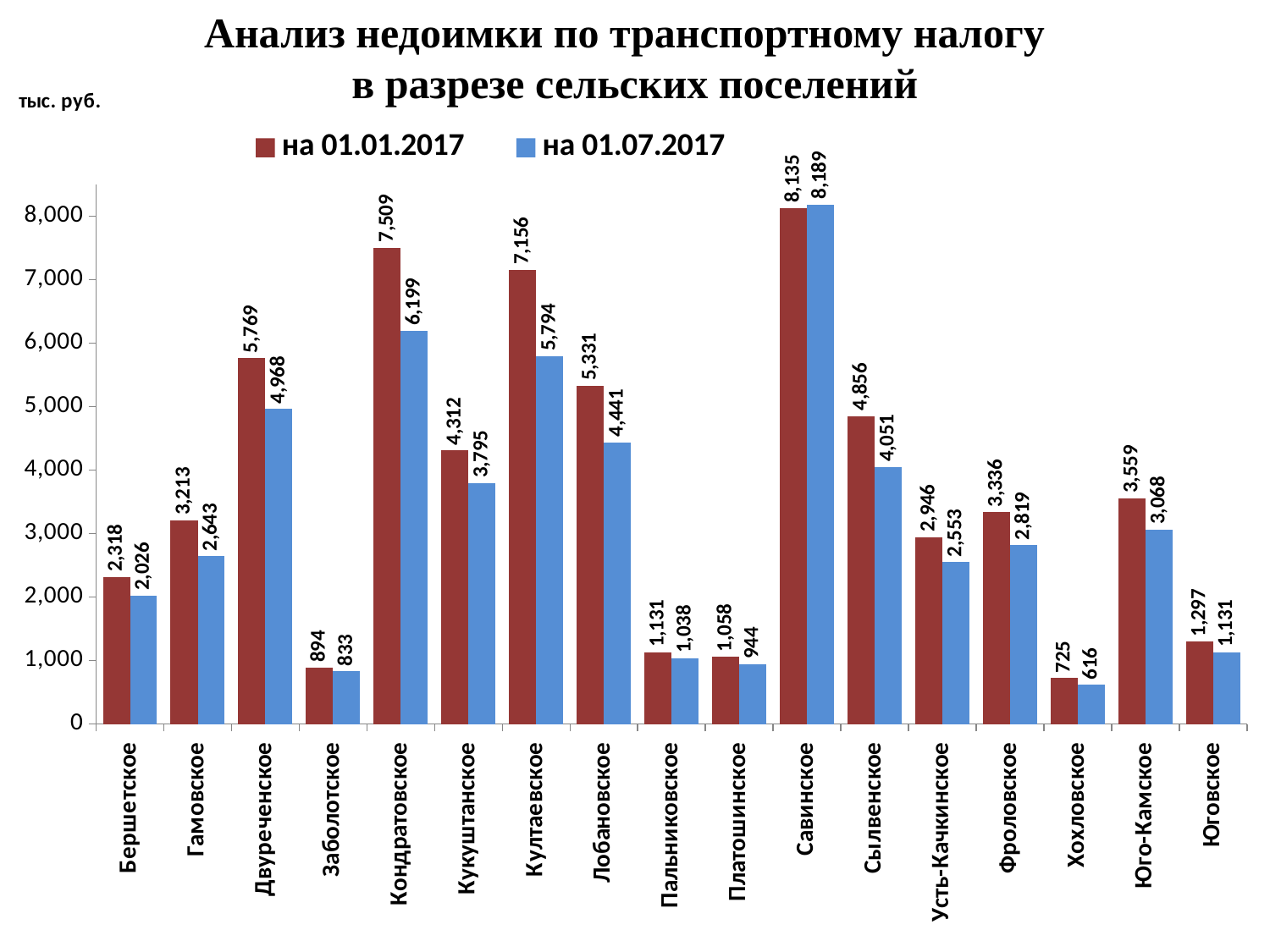
What is the value for Савинское in the series на 01.07.2017? 8,189 What is the difference between the на 01.01.2017 and на 01.07.2017 values for Кондратовское? 1,310 What kind of chart is shown on the slide? Bar chart What is the value for Хохловское in the series на 01.07.2017? 616 What is the value for Кондратовское in the series на 01.01.2017? 7,509 How many settlements are shown on the x axis? 17 Which settlement has the highest value in the series на 01.01.2017? Савинское What unit of measurement is indicated in the top-left corner of the chart? тыс. руб. Which is larger in the series на 01.01.2017: Двуреченское or Лобановское? Двуреченское Which settlement has the lowest value in the series на 01.07.2017? Хохловское Is the value for Кукуштанское in the series на 01.07.2017 greater or less than 4,000? less How many series does the legend list? 2